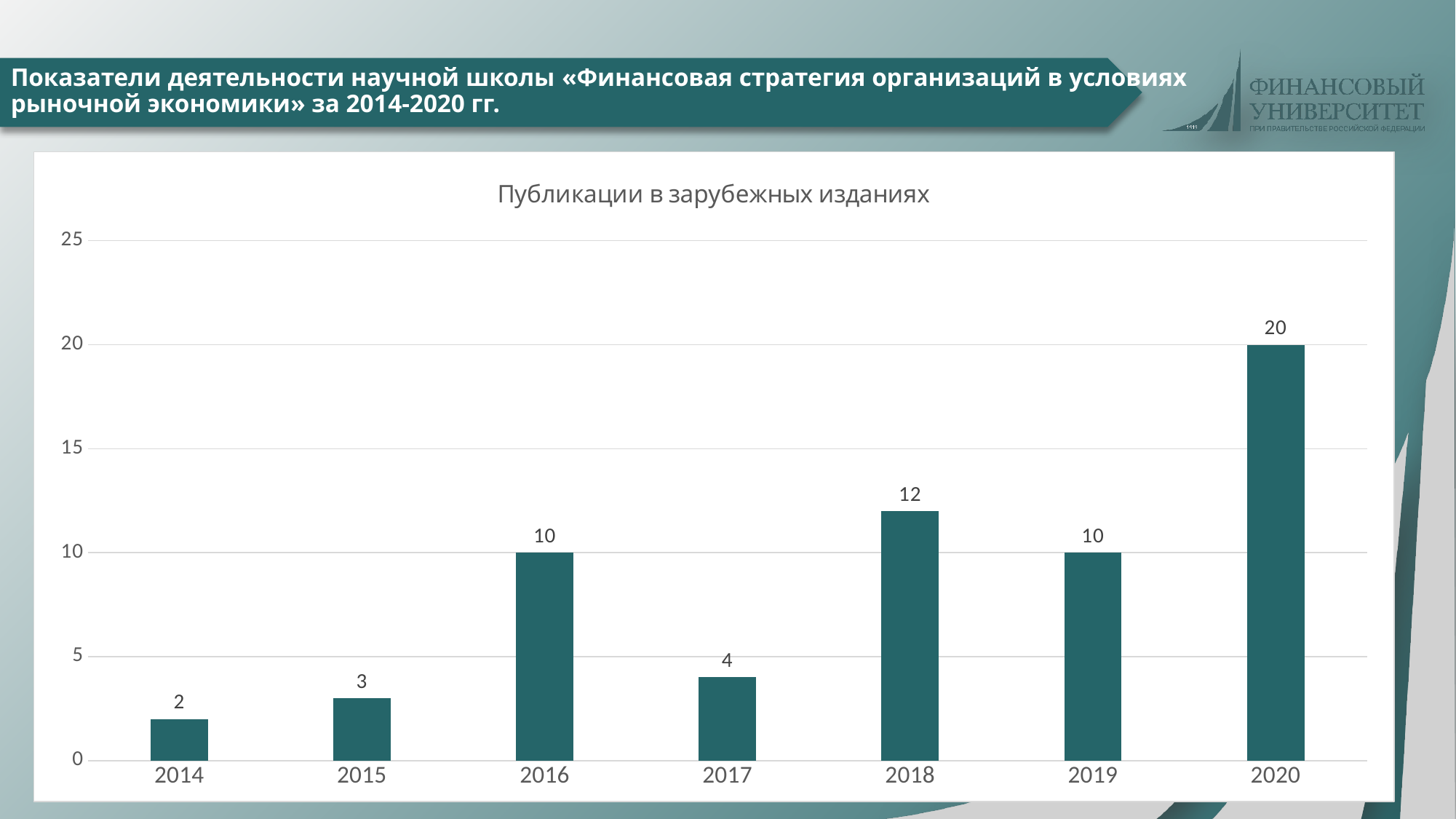
What is the difference between the values for 2017 and 2015? 1 What is the value for 2016? 10 Which year has the lowest value? 2014 How many years are shown on the x axis? 7 Which is larger, the value for 2017 or the value for 2019? 2019 What is the value for 2014? 2 What is the value for 2018? 12 Which year has the highest value? 2020 What is the title of the chart? Публикации в зарубежных изданиях Is the value for 2018 greater or less than 10? greater What is the difference between the values for 2020 and 2018? 8 What kind of chart is this? bar chart